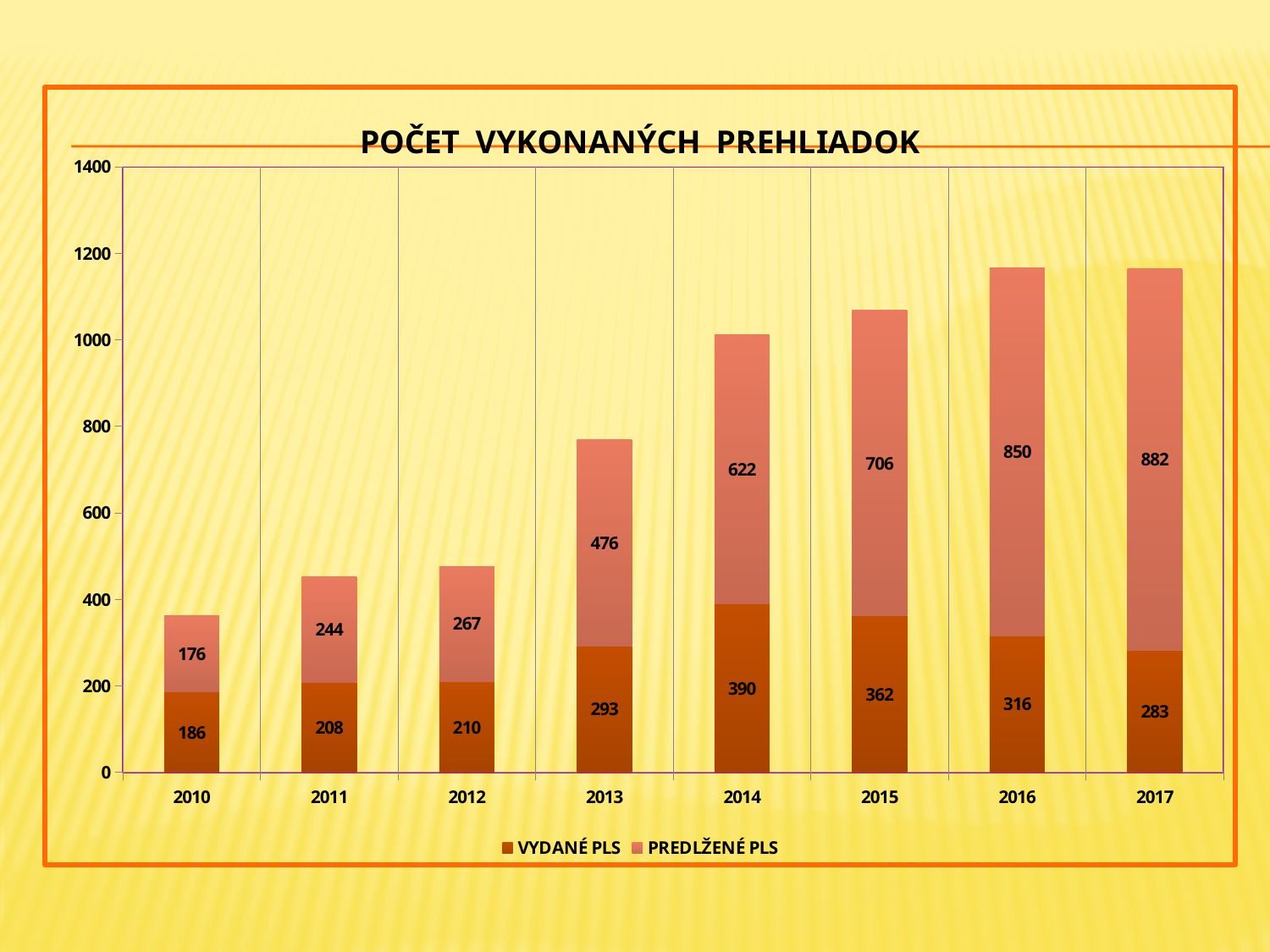
What is the total of the stacked bar for 2014? 1012 Is the total height of the stacked bar for 2013 greater or less than 800? less What is the value of PREDLŽENÉ PLS for 2017? 882 Which year has the lowest value for PREDLŽENÉ PLS? 2010 What kind of chart is shown on the slide? stacked bar chart How many series does the legend list? 2 What is the difference between PREDLŽENÉ PLS in 2016 and 2015? 144 Which year has the highest value for VYDANÉ PLS? 2014 What is the value of VYDANÉ PLS for 2014? 390 How many years are shown on the x axis? 8 What is the title of the chart? POČET VYKONANÝCH PREHLIADOK